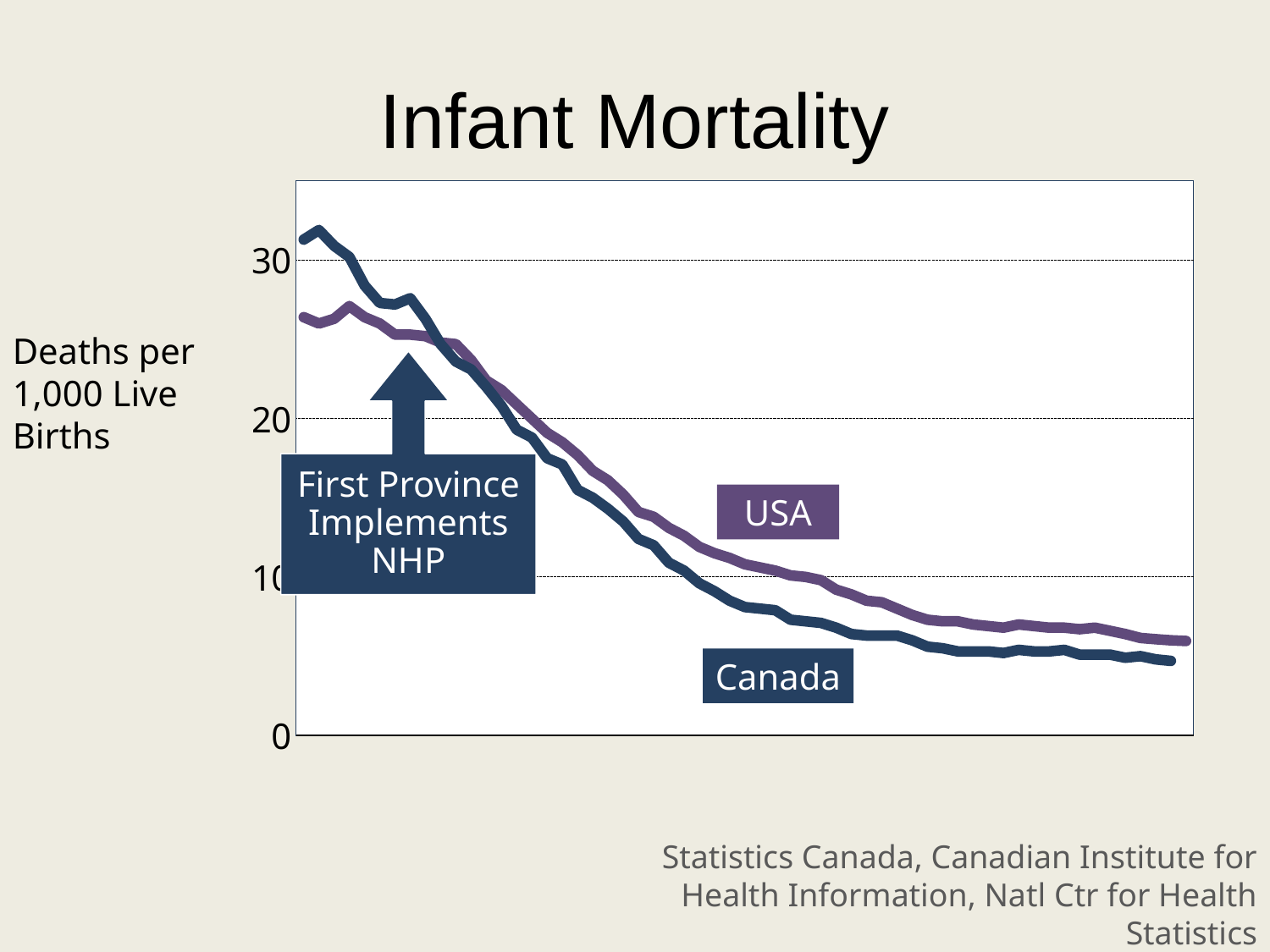
At the right edge of the chart, which series has the higher value, Canada or USA? USA How many series are plotted on the chart? 2 At the right edge of the chart, is the value for Canada greater or less than 10? less What is the title of the chart? Infant Mortality At the left edge of the chart, which series has the higher value, Canada or USA? Canada At the left edge of the chart, is the value for Canada greater or less than 30? greater At the left edge of the chart, is the value for USA greater or less than 30? less Does the Canada line rise or fall from left to right? fall Does the USA line rise or fall from left to right? fall What does the vertical axis measure, according to the label on the slide? Deaths per 1,000 Live Births What kind of chart is shown on the slide? line chart